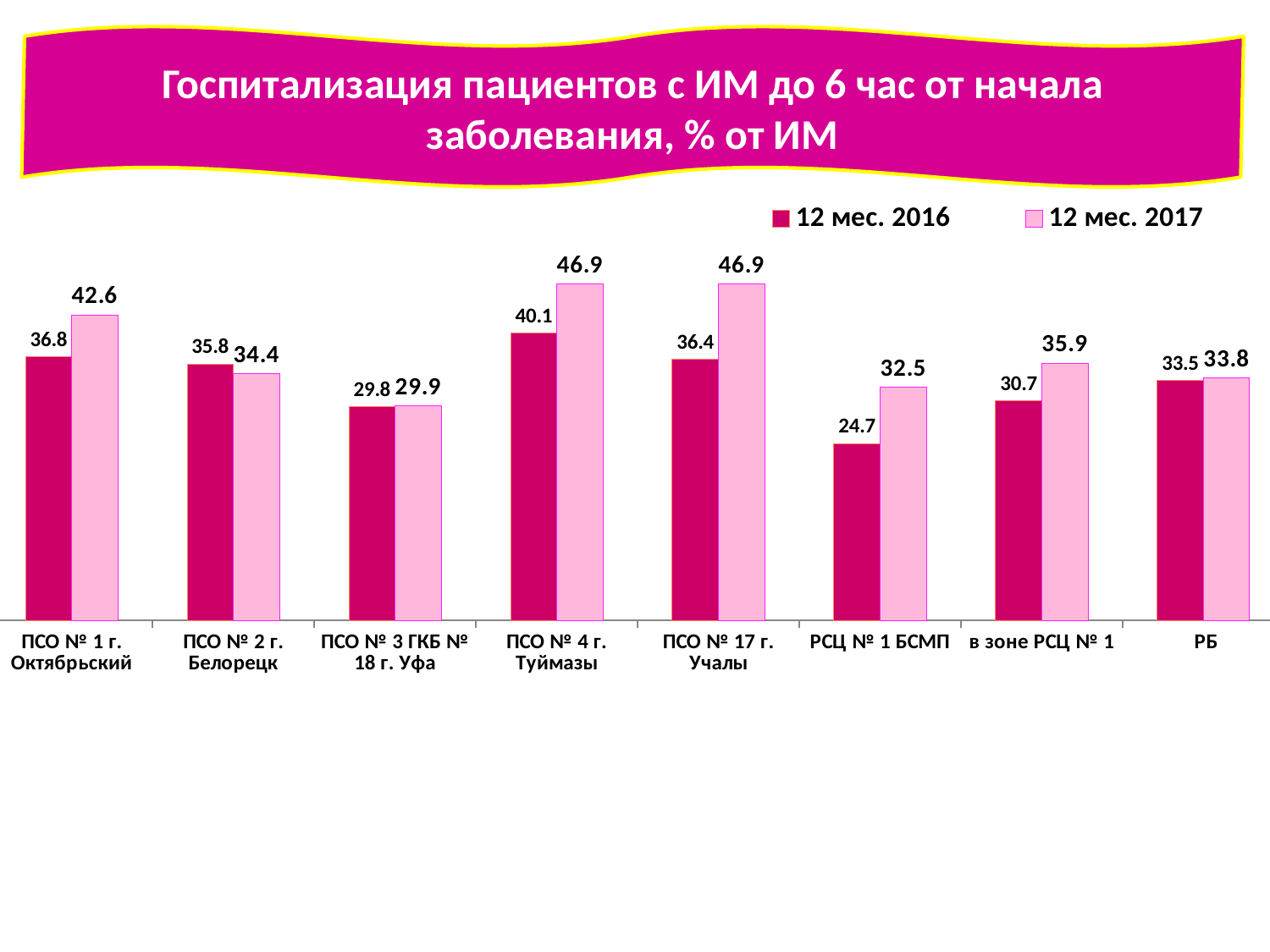
What is the difference between the 12 мес. 2017 and 12 мес. 2016 values for ПСО № 4 г. Туймазы? 6.8 What kind of chart is shown on the slide? Bar chart What is the value for РБ in the 12 мес. 2017 series? 33.8 What is the difference between the 12 мес. 2017 and 12 мес. 2016 values for РСЦ № 1 БСМП? 7.8 Which category has the highest value in the 12 мес. 2016 series? ПСО № 4 г. Туймазы Which category has the lowest value in the 12 мес. 2017 series? ПСО № 3 ГКБ № 18 г. Уфа What is the value for РСЦ № 1 БСМП in the 12 мес. 2016 series? 24.7 How many categories are shown on the x axis? 8 How many series does the legend list? 2 What is the value for ПСО № 1 г. Октябрьский in the 12 мес. 2017 series? 42.6 Which category has the lowest value in the 12 мес. 2016 series? РСЦ № 1 БСМП For ПСО № 2 г. Белорецк, which series has the larger value, 12 мес. 2016 or 12 мес. 2017? 12 мес. 2016